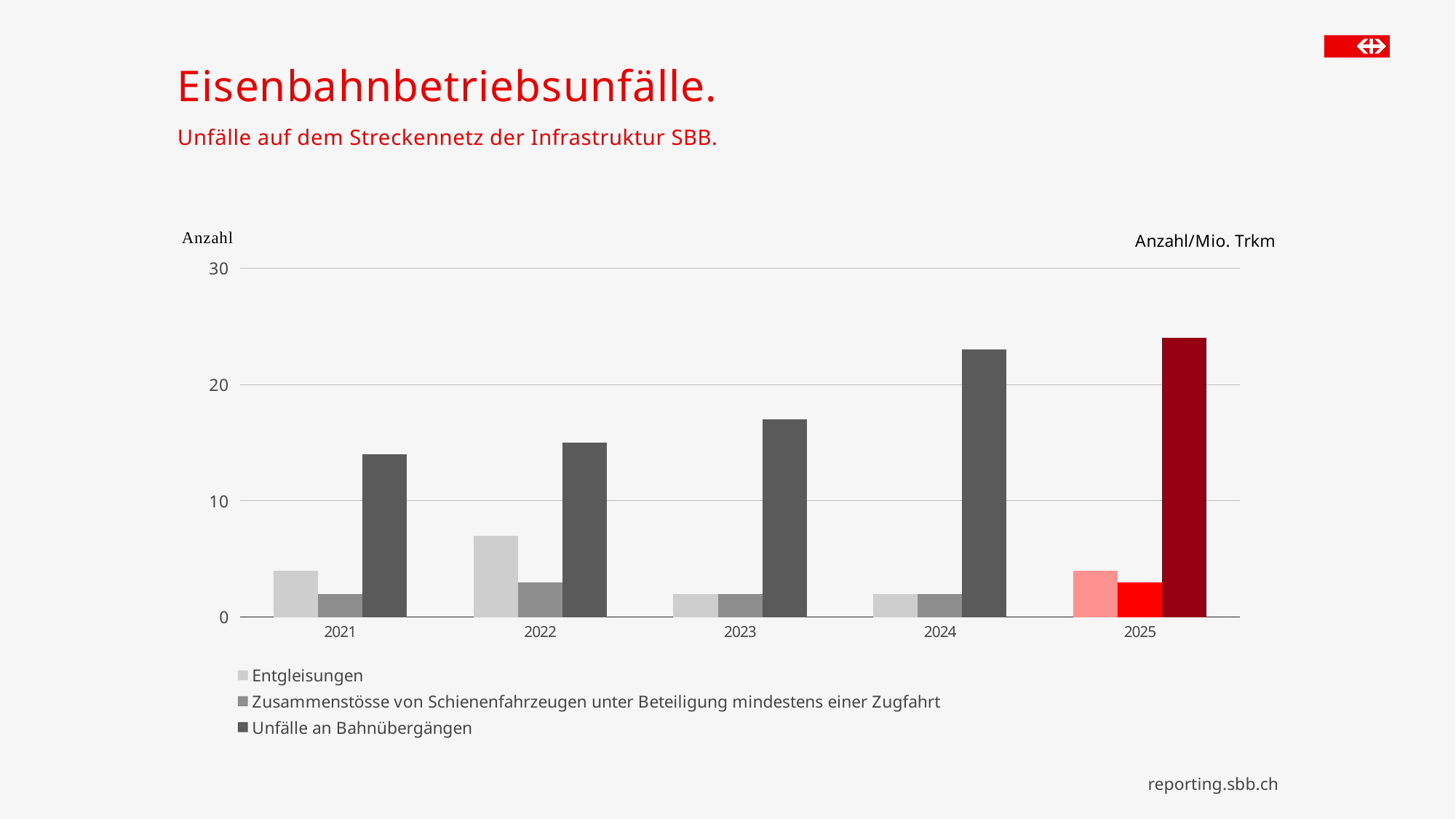
Is the value for Unfälle an Bahnübergängen in 2022 greater or less than 20? less Is the value for Unfälle an Bahnübergängen in 2024 greater or less than 20? greater How many years are shown on the x axis? 5 Which year has the highest value for Unfälle an Bahnübergängen? 2025 What kind of chart is shown on the slide? bar chart How many series does the legend list? 3 Which year has the lowest value for Unfälle an Bahnübergängen? 2021 Which is larger: Unfälle an Bahnübergängen in 2023 or in 2021? 2023 Do the values for Unfälle an Bahnübergängen rise or fall from 2021 to 2025? rise What is the title of the slide? Eisenbahnbetriebsunfälle. Which year has the highest value for Entgleisungen? 2022 Is the value for Entgleisungen in 2022 greater or less than 10? less